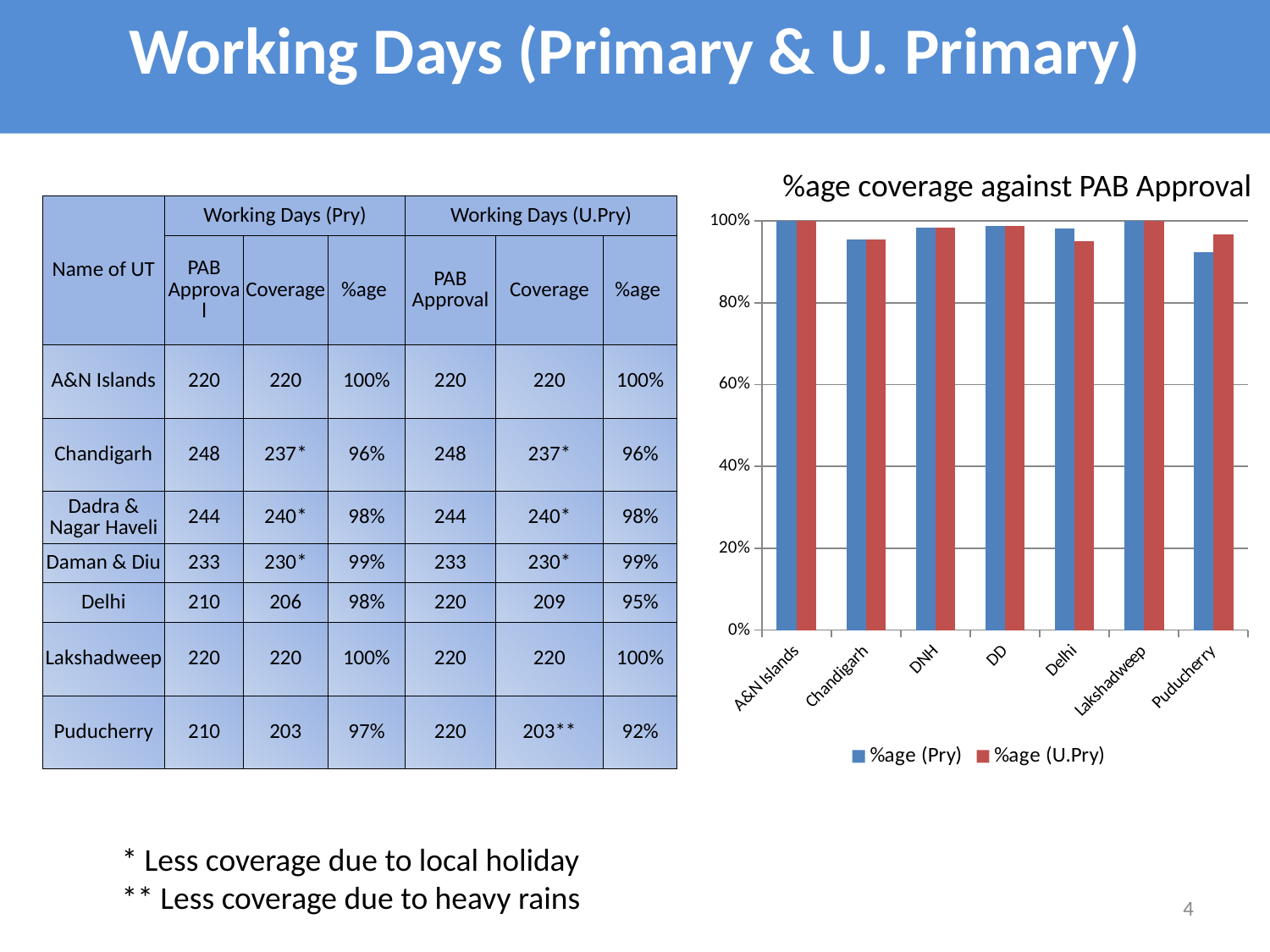
What is the %age (Pry) value for A&N Islands in the chart? 100% How many series does the chart legend list? 2 What is the %age (U.Pry) value for Delhi? 95% What kind of chart is shown on the slide? bar chart For Delhi, which is larger in the chart: %age (Pry) or %age (U.Pry)? %age (Pry) What is the title of the chart? %age coverage against PAB Approval What is the %age (U.Pry) value for Lakshadweep in the chart? 100% What is the %age (Pry) value for Delhi? 98% Is the %age (U.Pry) value for Chandigarh greater or less than 80%? greater How many UTs (categories) are shown on the x axis of the chart? 7 Which series is shown in blue in the chart? %age (Pry) Is the %age (Pry) value for Puducherry greater or less than 100%? less